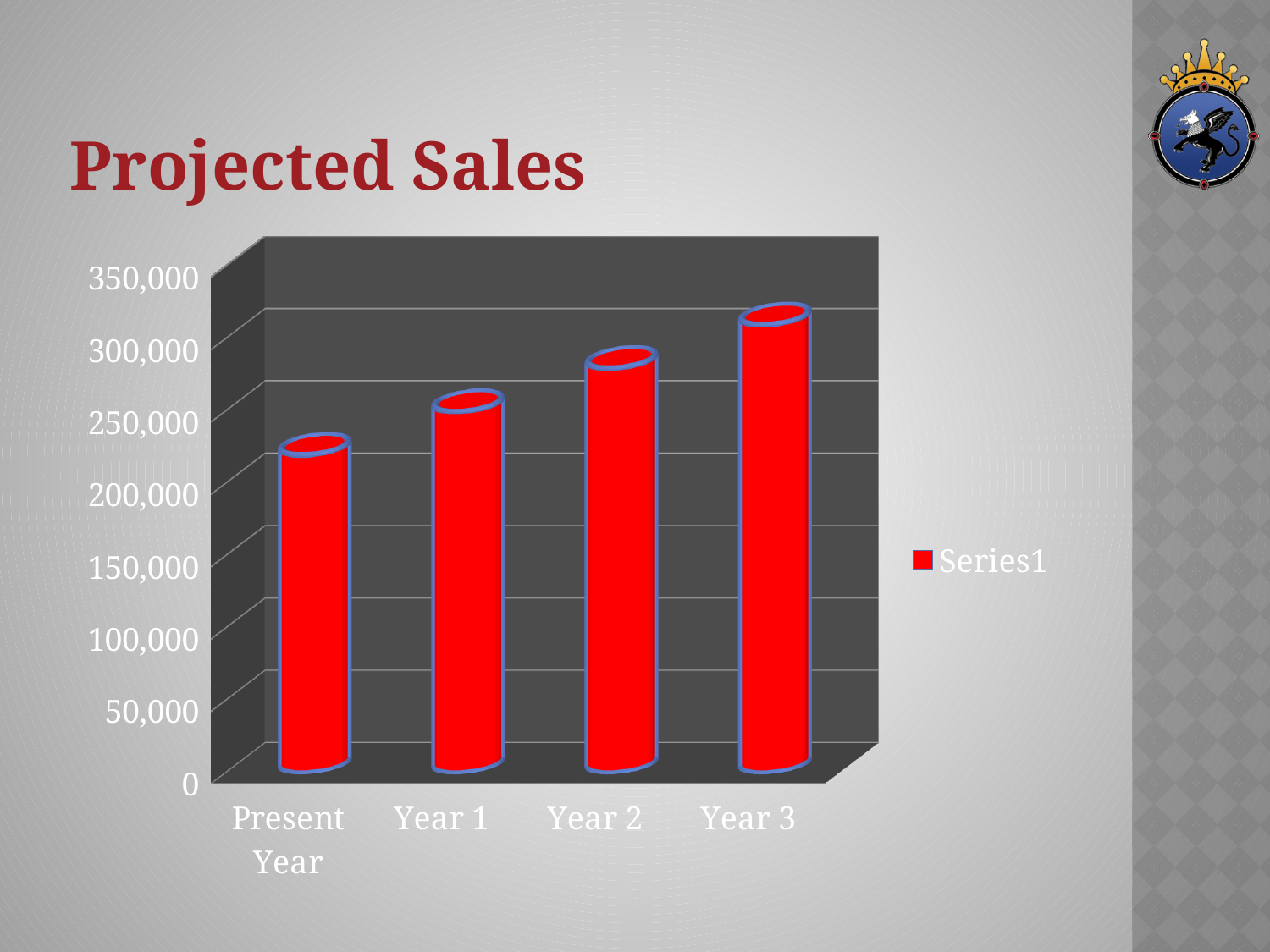
Which category has the highest value in the chart? Year 3 How many categories are shown on the x axis of the chart? 4 What kind of chart is shown on the slide? bar chart Do the values rise or fall from Present Year to Year 3? rise Is the value for Present Year greater or less than 200,000? greater What is the title of the slide's chart? Projected Sales What is the name of the series shown in the legend? Series1 How many series does the chart's legend list? 1 Is the value for Year 1 greater or less than 300,000? less Which is larger, the value for Year 1 or the value for Year 3? Year 3 Which category has the lowest value in the chart? Present Year